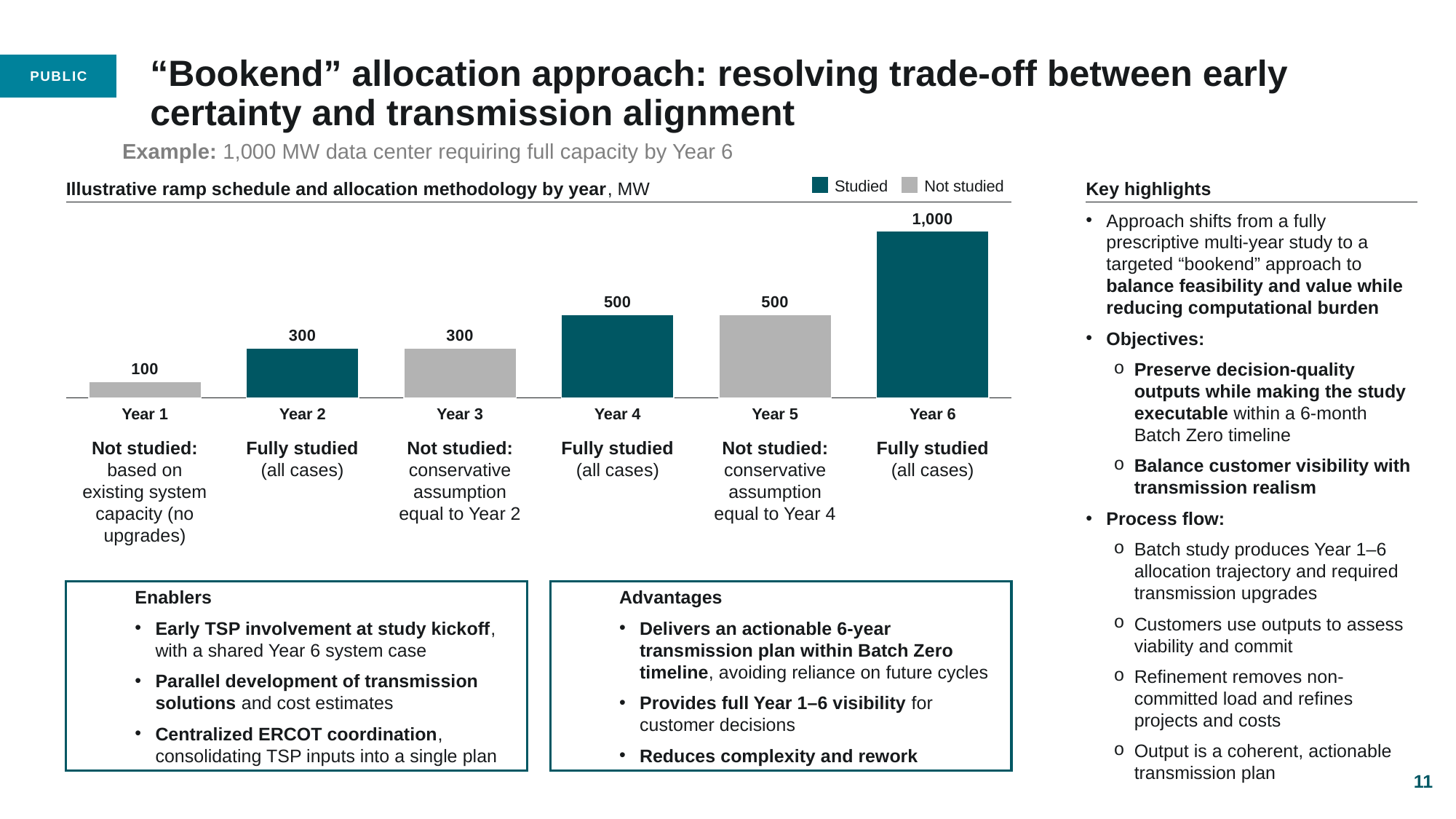
What is the value for Year 6? 1,000 Which legend entry is shown in dark teal? Studied What is the difference between the values for Year 2 and Year 1? 200 Which is larger, the value for Year 3 or the value for Year 4? Year 4 How many series does the legend list? 2 Which year has the lowest value? Year 1 Which year has the highest value? Year 6 How many years are shown on the x axis? 6 What is the value for Year 4? 500 What is the difference between the values for Year 6 and Year 5? 500 What kind of chart is shown? Bar chart What is the value for Year 1? 100